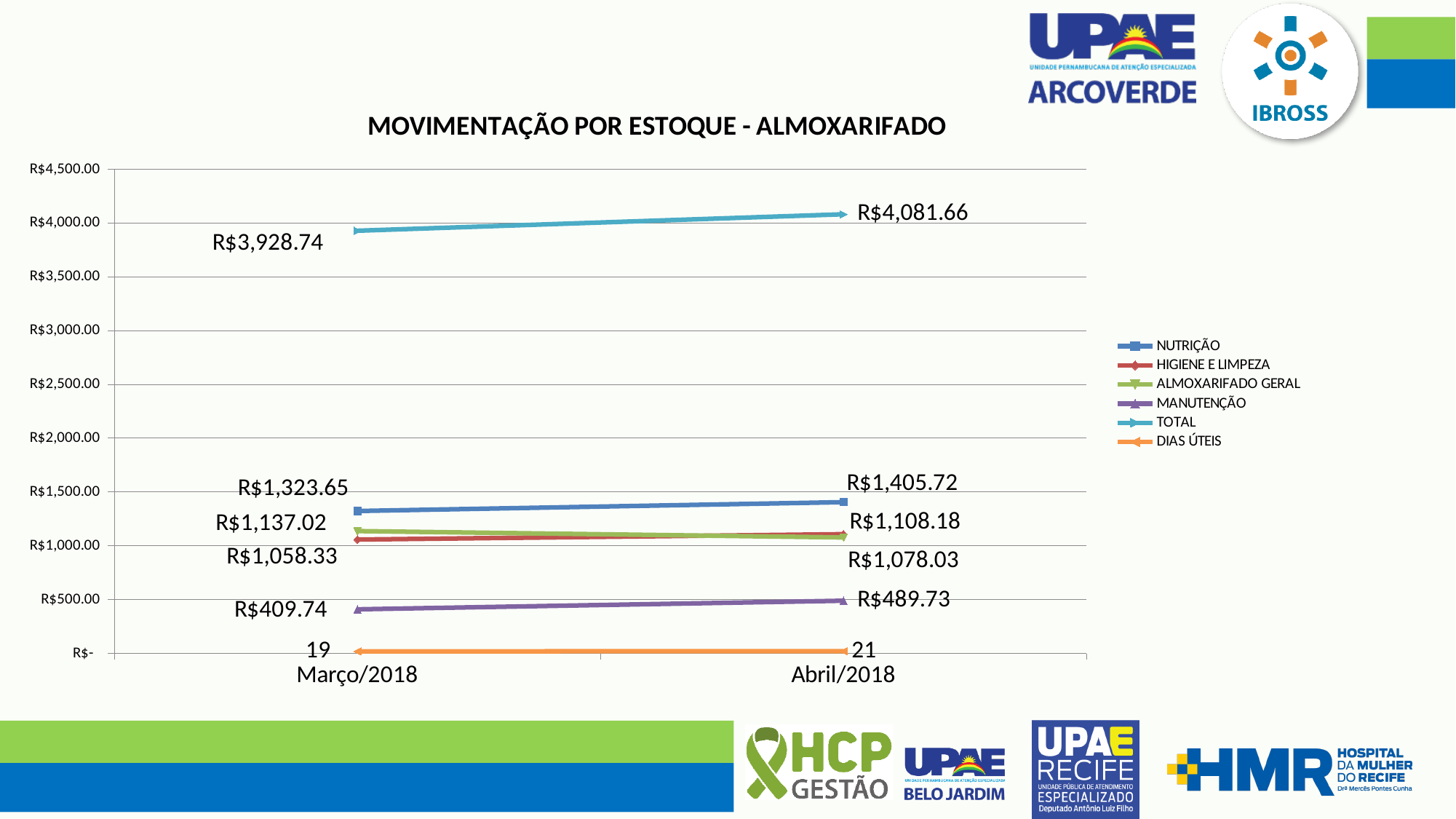
What kind of chart is shown on the slide? line chart How many periods are shown on the x axis? 2 Does the TOTAL line rise or fall from Março/2018 to Abril/2018? rises How many series does the legend list? 6 What is the MANUTENÇÃO value for Abril/2018? R$489.73 Which series has the lowest monetary value in Março/2018: NUTRIÇÃO, HIGIENE E LIMPEZA, ALMOXARIFADO GERAL or MANUTENÇÃO? MANUTENÇÃO What is the TOTAL value for Abril/2018? R$4,081.66 By how much did the TOTAL increase from Março/2018 to Abril/2018? R$152.92 What is the title of the chart? MOVIMENTAÇÃO POR ESTOQUE - ALMOXARIFADO What is the NUTRIÇÃO value for Março/2018? R$1,323.65 What is the difference between the NUTRIÇÃO values for Abril/2018 and Março/2018? R$82.07 How many DIAS ÚTEIS are shown for Março/2018? 19